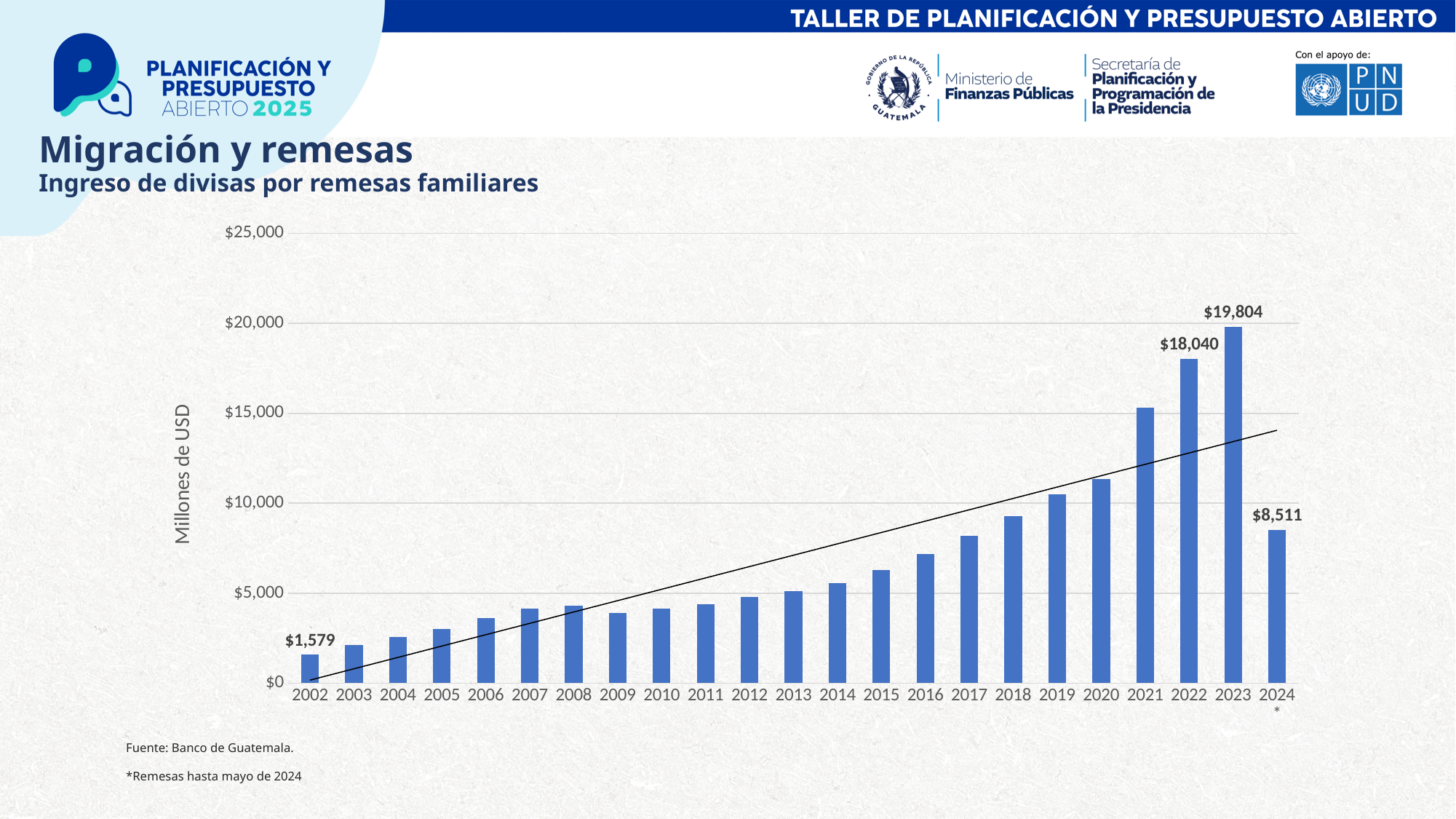
What is the difference between the values for 2023 and 2022? $1,764 What is the value for 2024? $8,511 Which year has the highest value? 2023 How many years are shown on the x axis? 23 Is the value for 2019 greater or less than $10,000? greater Which year has the lowest value? 2002 What kind of chart is this? bar chart What is the value for 2023? $19,804 Which is larger, the value for 2021 or the value for 2024? 2021 What is the value for 2002? $1,579 What is the value for 2022? $18,040